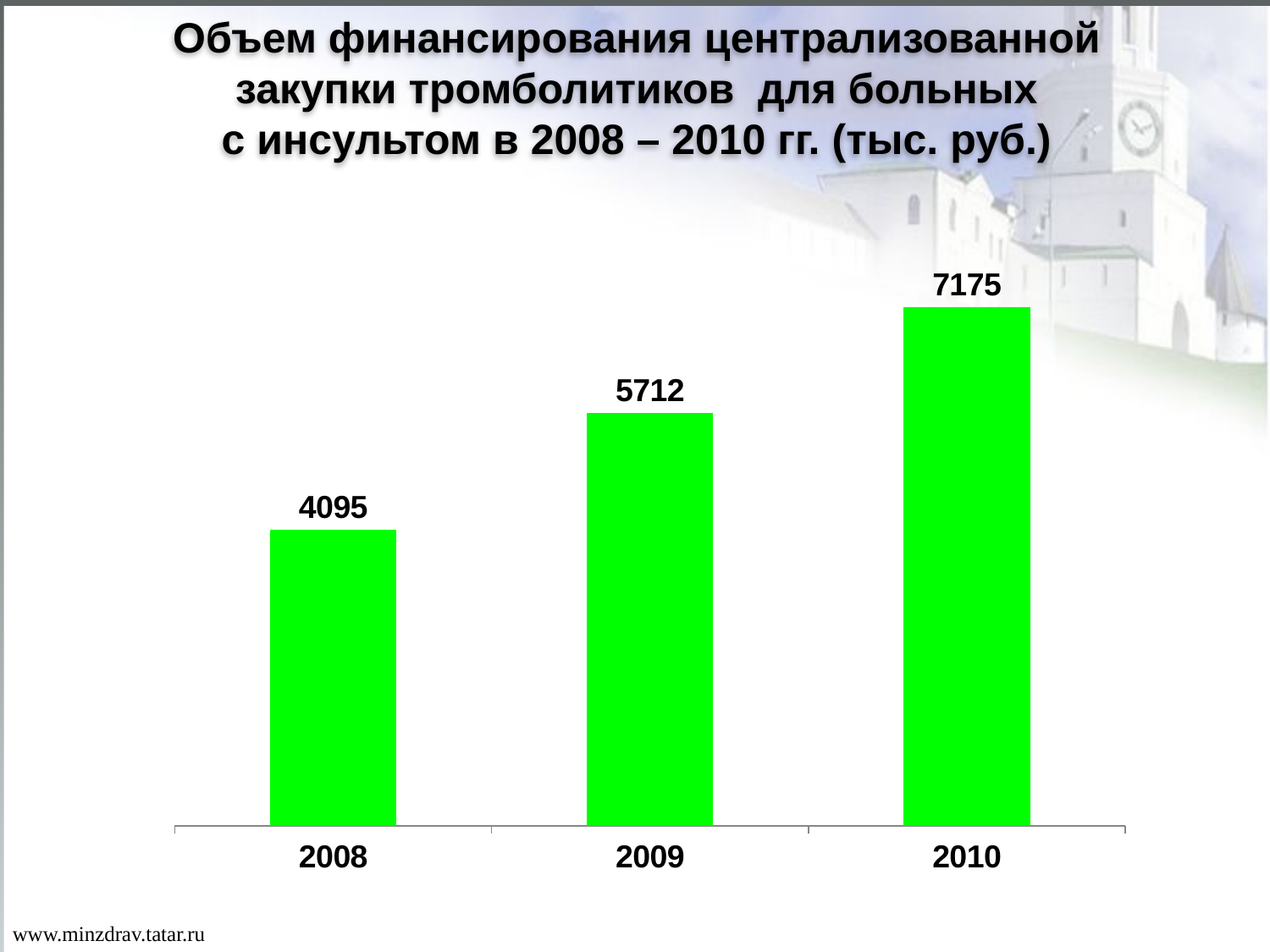
Which year has the highest value? 2010 What is the difference between the values for 2009 and 2008? 1617 What is the difference between the values for 2010 and 2008? 3080 Which year has the lowest value? 2008 What is the value for 2008? 4095 What kind of chart is shown on the slide? bar chart Which is larger, the value for 2009 or the value for 2010? 2010 Do the values rise or fall from 2008 to 2010? rise How many years are shown on the chart? 3 What colour are the bars on the chart? green What is the value for 2009? 5712 What is the value for 2010? 7175